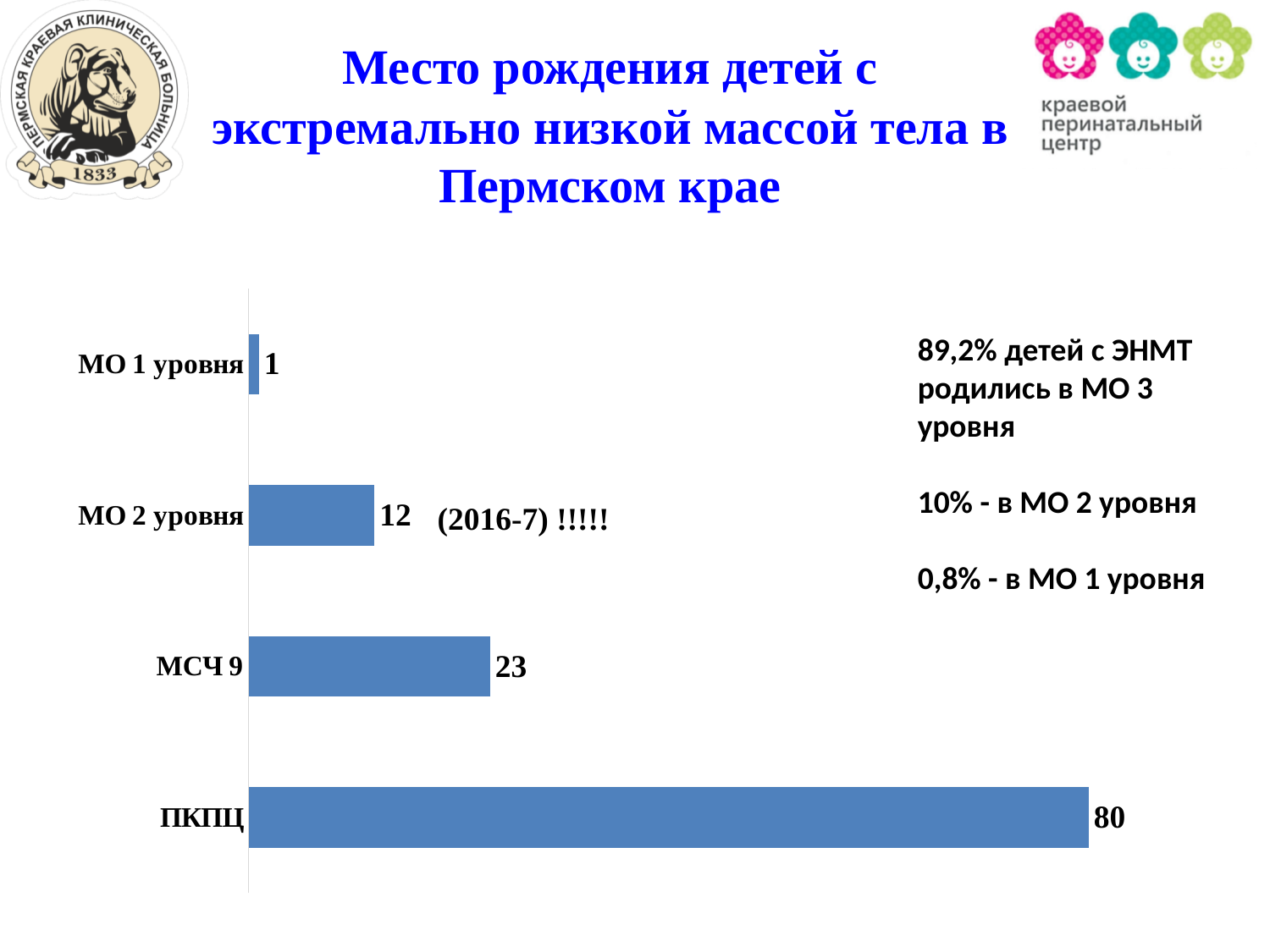
Which category has the highest value? ПКПЦ What is the value for МО 1 уровня? 1 What is the difference between the values for ПКПЦ and МСЧ 9? 57 What is the value for ПКПЦ? 80 Which category has the lowest value? МО 1 уровня What is the value for МСЧ 9? 23 What is the total of all four values shown in the chart? 116 Which is larger, the value for МО 2 уровня or the value for МСЧ 9? МСЧ 9 What is the difference between the values for МСЧ 9 and МО 2 уровня? 11 What is the value for МО 2 уровня? 12 What kind of chart is shown on the slide? bar chart How many categories are shown in the chart? 4